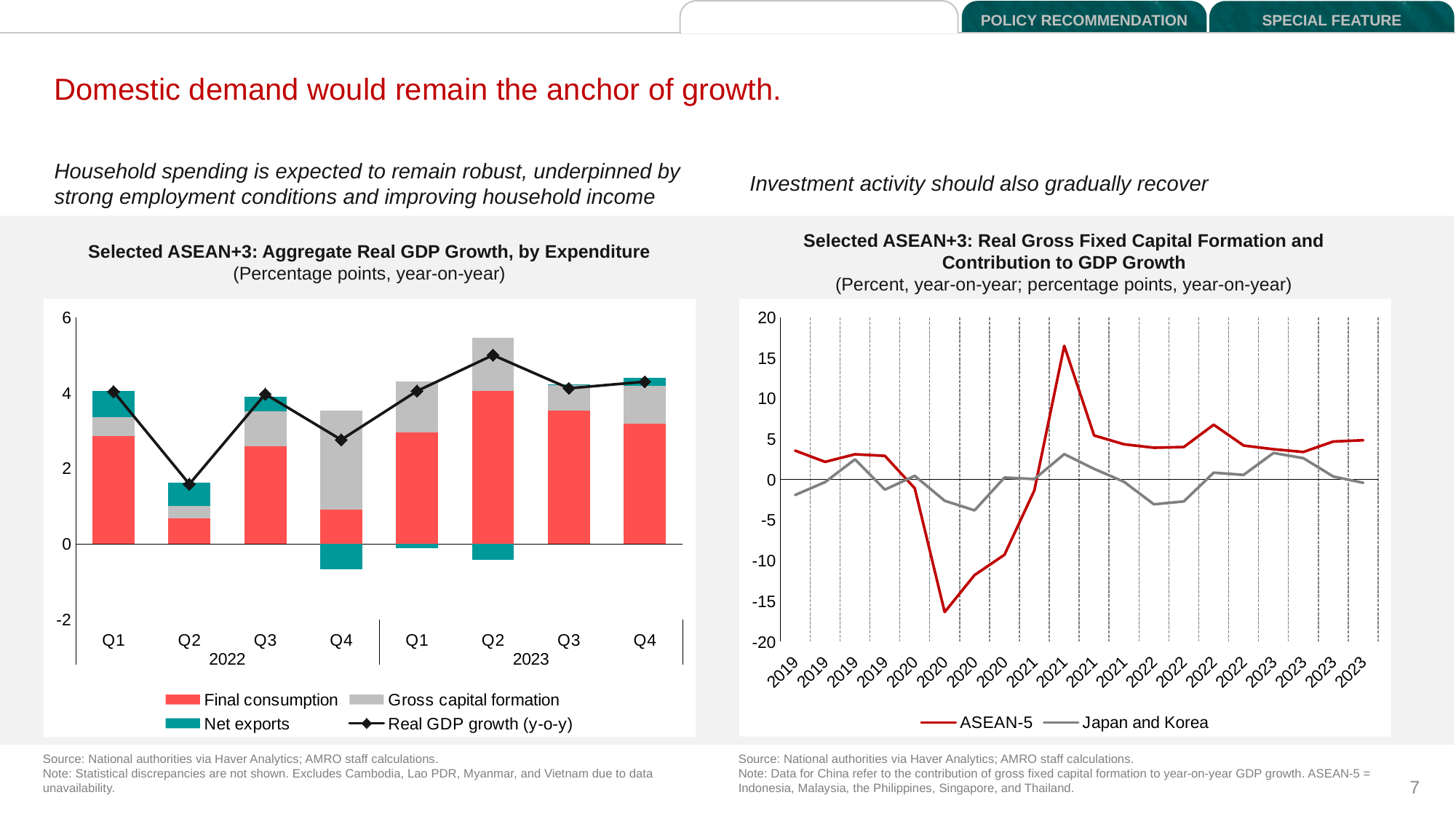
In the left chart, in which quarter is Real GDP growth (y-o-y) highest? Q2 2023 In the right chart, which series reaches the lowest value, ASEAN-5 or Japan and Korea? ASEAN-5 In the right chart, how many series does the legend list? 2 In the left chart, is Real GDP growth (y-o-y) for Q2 2022 greater or less than 2? less In the left chart, how many quarterly bars are plotted? 8 In the left chart, in which quarter is Real GDP growth (y-o-y) lowest? Q2 2022 In the left chart, is the Final consumption contribution larger in Q2 2022 or Q2 2023? Q2 2023 What kind of chart is the left chart, 'Selected ASEAN+3: Aggregate Real GDP Growth, by Expenditure'? Stacked bar chart with a line In the left chart, how many series does the legend list? 4 What kind of chart is the right chart, 'Selected ASEAN+3: Real Gross Fixed Capital Formation and Contribution to GDP Growth'? Line chart In the right chart, is the peak value of the ASEAN-5 line in 2021 greater or less than 15? greater In the left chart, is Real GDP growth (y-o-y) for Q2 2023 greater or less than 4? greater